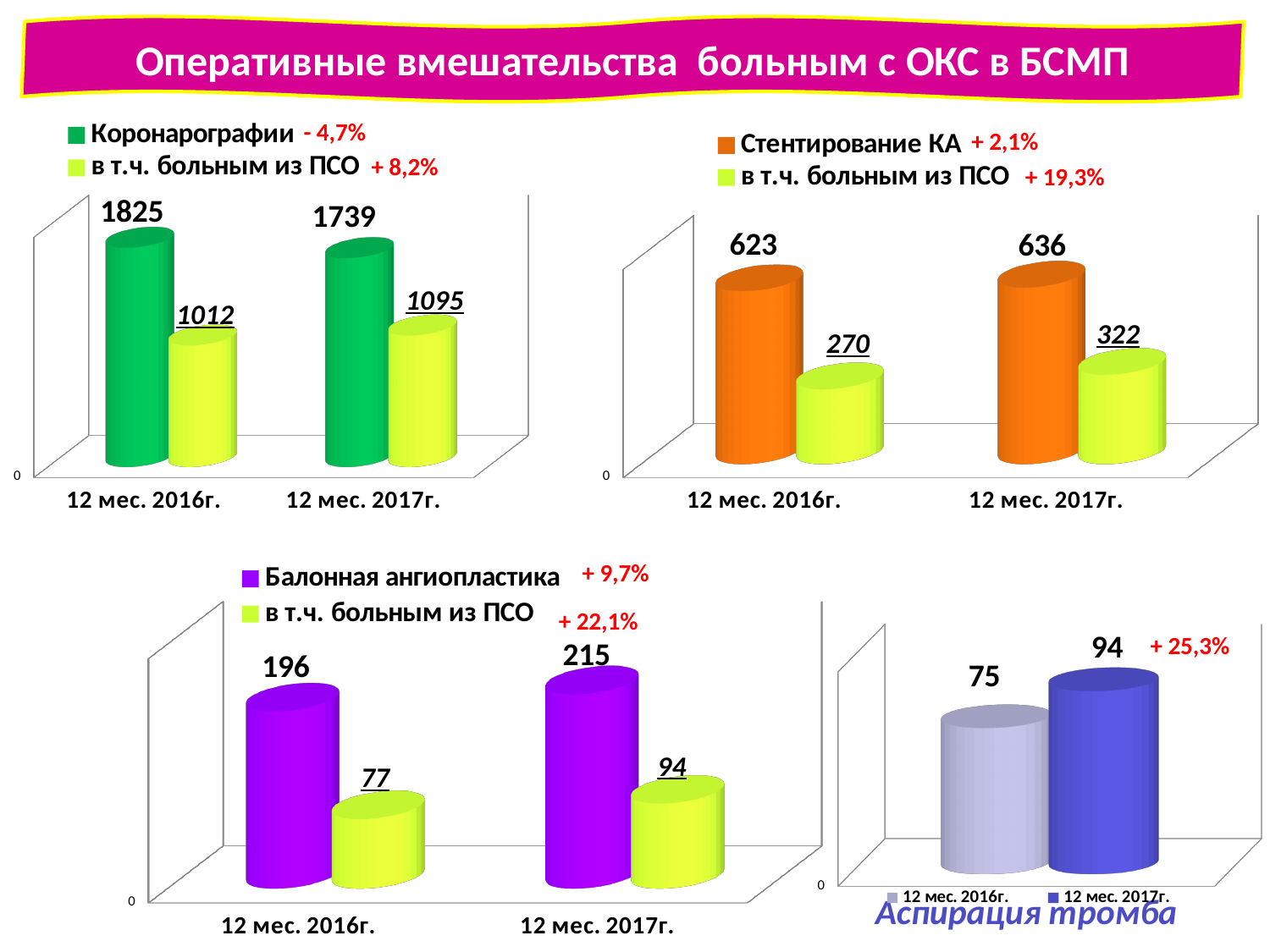
How many series does the legend of the top-left chart (Коронарографии) list? 2 In the top-right chart (Стентирование КА), what is the value for в т.ч. больным из ПСО in 12 мес. 2016г.? 270 What kind of chart is the bottom-right chart (Аспирация тромба)? bar chart In the bottom-left chart (Балонная ангиопластика), what is the difference between the в т.ч. больным из ПСО values for 12 мес. 2017г. and 12 мес. 2016г.? 17 In the top-right chart (Стентирование КА), does the value for в т.ч. больным из ПСО rise or fall from 12 мес. 2016г. to 12 мес. 2017г.? rise In the top-left chart (Коронарографии), what is the difference between the Коронарографии values for 12 мес. 2016г. and 12 мес. 2017г.? 86 In the bottom-left chart (Балонная ангиопластика), what is the value for Балонная ангиопластика in 12 мес. 2016г.? 196 In the bottom-right chart (Аспирация тромба), what is the value for 12 мес. 2016г.? 75 In the top-left chart (Коронарографии), what is the value for в т.ч. больным из ПСО in 12 мес. 2017г.? 1095 In the top-left chart (Коронарографии), what is the value for Коронарографии in 12 мес. 2016г.? 1825 In the top-right chart (Стентирование КА), what is the value for Стентирование КА in 12 мес. 2017г.? 636 In the bottom-right chart (Аспирация тромба), which period has the higher value? 12 мес. 2017г.